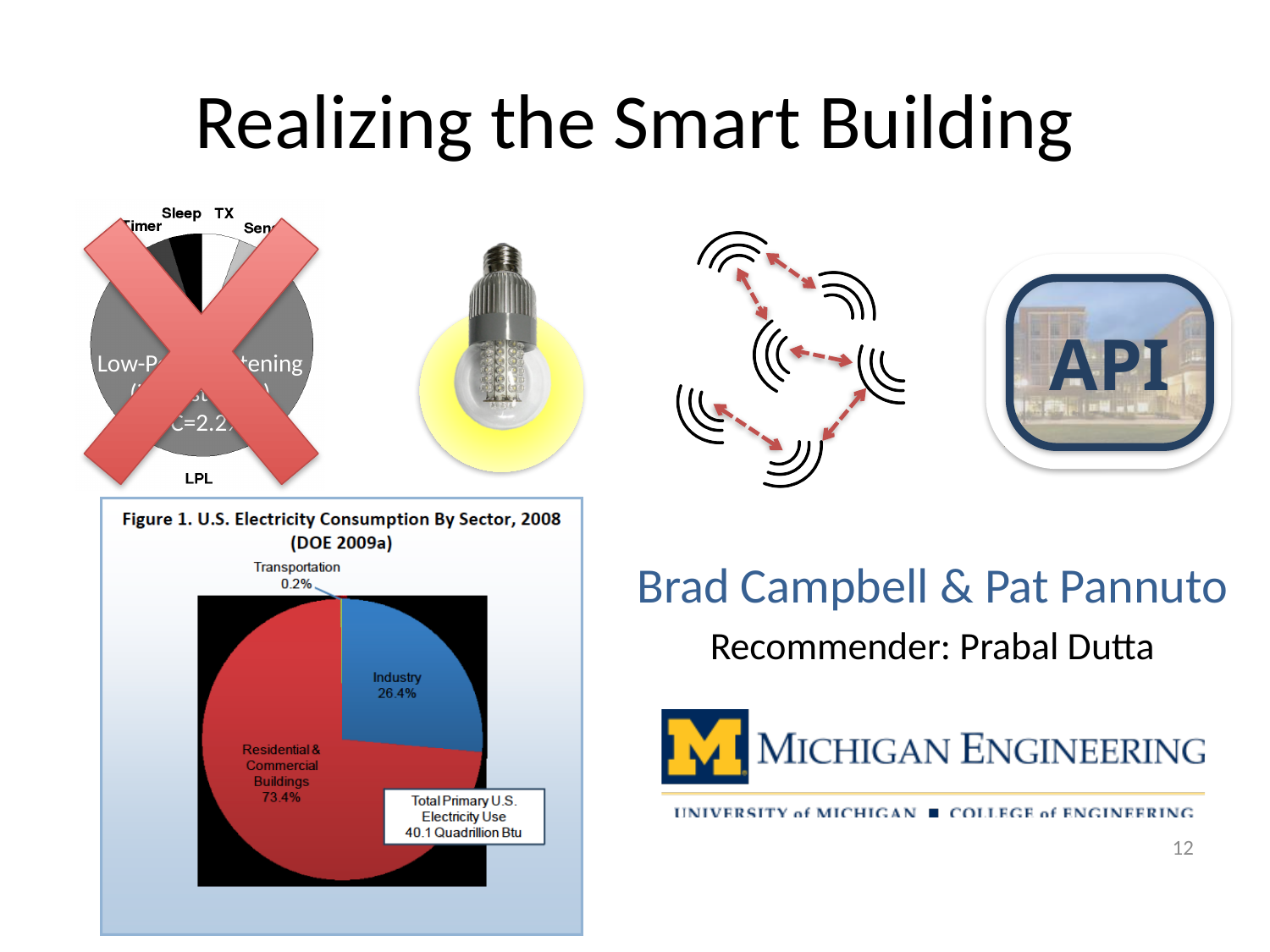
In the U.S. Electricity Consumption By Sector pie chart, what share is labelled for Transportation? 0.2% In the U.S. Electricity Consumption By Sector pie chart, what share is labelled for Industry? 26.4% According to the text box in the U.S. Electricity Consumption By Sector chart, what is the total primary U.S. electricity use? 40.1 Quadrillion Btu In the U.S. Electricity Consumption By Sector pie chart, which sector has the smallest share? Transportation How many sectors are shown in the U.S. Electricity Consumption By Sector pie chart? 3 What kind of chart is the U.S. Electricity Consumption By Sector chart at the bottom left of the slide? Pie chart In the U.S. Electricity Consumption By Sector pie chart, which is larger, the Industry slice or the Transportation slice? Industry What year does the U.S. Electricity Consumption By Sector chart's title say the data is for? 2008 In the U.S. Electricity Consumption By Sector pie chart, what share is labelled for Residential & Commercial Buildings? 73.4% In the U.S. Electricity Consumption By Sector pie chart, which sector has the largest share? Residential & Commercial Buildings In the U.S. Electricity Consumption By Sector pie chart, by how many percentage points does Industry exceed Transportation? 26.2 percentage points In the U.S. Electricity Consumption By Sector pie chart, by how many percentage points does Residential & Commercial Buildings exceed Industry? 47.0 percentage points